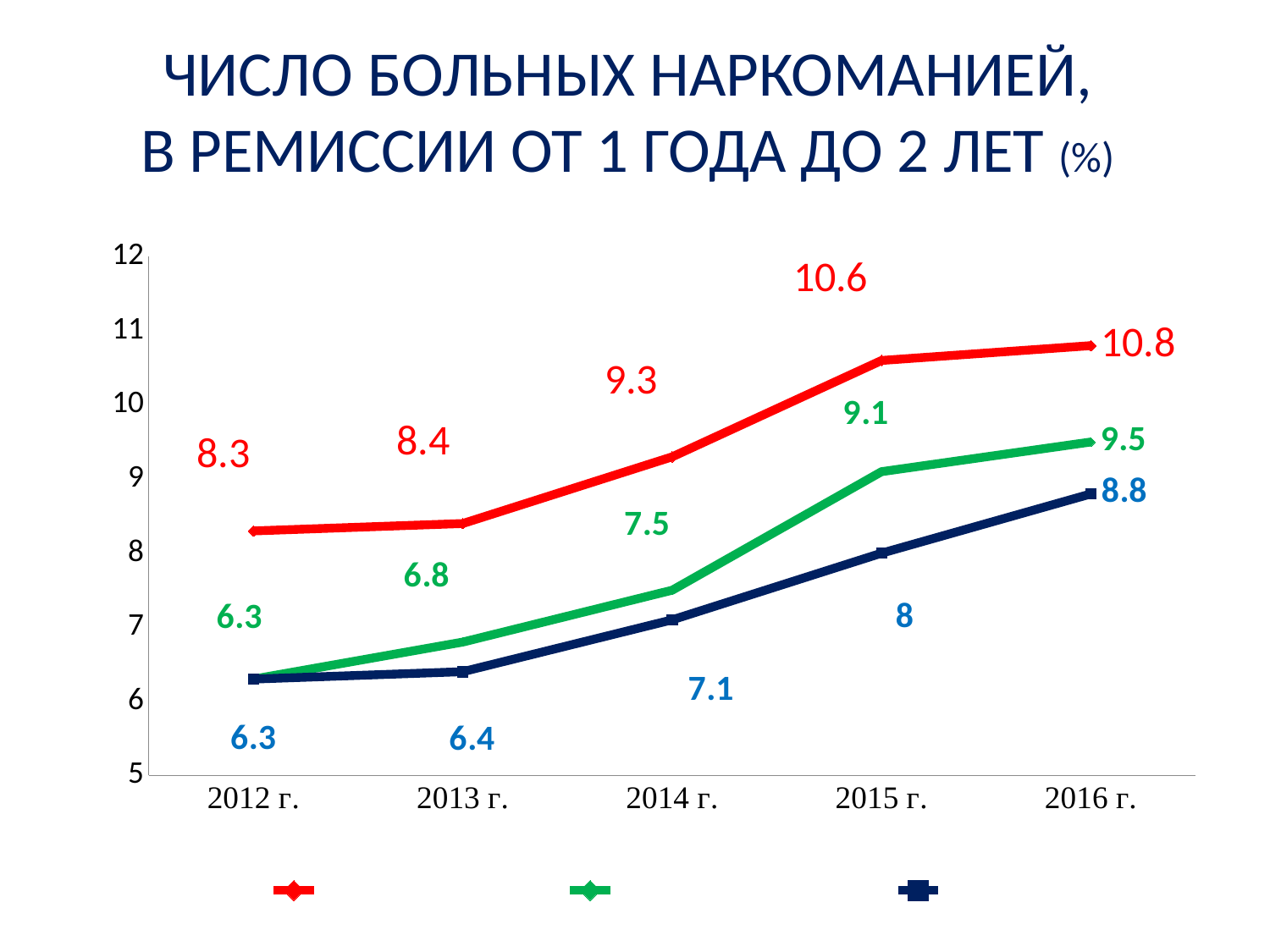
What is the difference between the red line values in 2015 г. and 2014 г.? 1.3 In which year is the green line at its lowest value? 2012 г. What kind of chart is shown on the slide? line chart Which is larger in 2015 г., the green line value or the dark blue line value? the green line (9.1) How many series does the legend list? 3 Do the values of the dark blue line rise or fall from 2012 г. to 2016 г.? rise What is the value of the dark blue line for 2015 г.? 8 What is the value of the red line for 2016 г.? 10.8 What is the value of the green line for 2014 г.? 7.5 How many years are shown on the x axis? 5 What is the difference between the red line and the dark blue line in 2016 г.? 2 In which year does the red line reach its highest value? 2016 г.